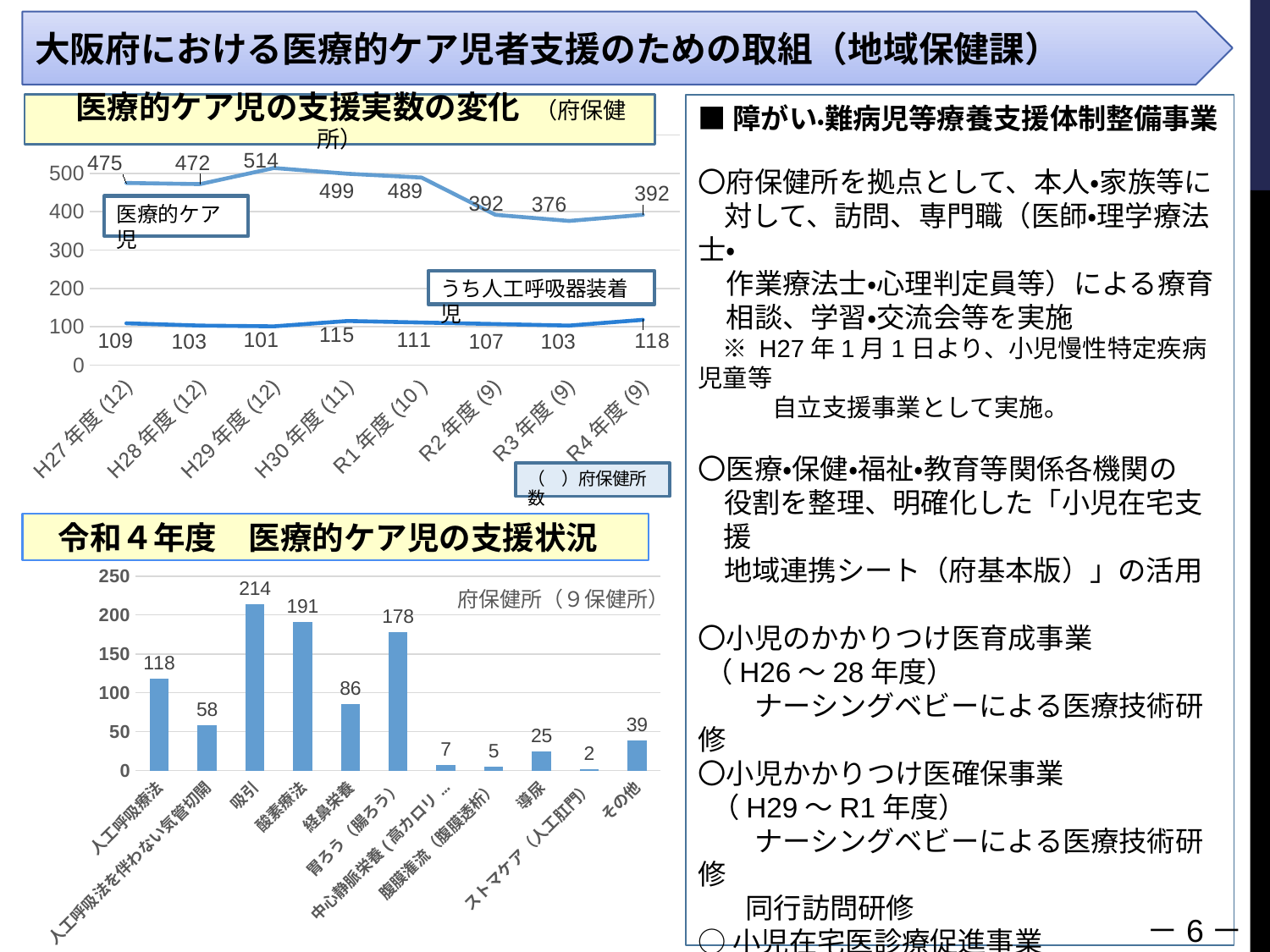
In the top chart '医療的ケア児の支援実数の変化', what kind of chart is used? Line chart In the bottom chart '令和4年度 医療的ケア児の支援状況', which category has the lowest value? ストマケア（人工肛門） In the bottom chart '令和4年度 医療的ケア児の支援状況', what is the difference between 吸引 and 胃ろう（腸ろう）? 36 In the bottom chart '令和4年度 医療的ケア児の支援状況', which category has the highest value? 吸引 In the top chart '医療的ケア児の支援実数の変化', what is the value for うち人工呼吸器装着児 in R4年度? 118 In the top chart '医療的ケア児の支援実数の変化', what is the value for 医療的ケア児 in H29年度? 514 In the bottom chart '令和4年度 医療的ケア児の支援状況', how many categories are shown? 11 In the bottom chart '令和4年度 医療的ケア児の支援状況', what is the value for 酸素療法? 191 In the top chart '医療的ケア児の支援実数の変化', how many years are plotted along the x axis? 8 In the bottom chart '令和4年度 医療的ケア児の支援状況', which is larger, 人工呼吸療法 or 経鼻栄養? 人工呼吸療法 In the top chart '医療的ケア児の支援実数の変化', which year has the lowest value for 医療的ケア児? R3年度 In the top chart '医療的ケア児の支援実数の変化', what is the difference between the 医療的ケア児 values for H29年度 and R3年度? 138